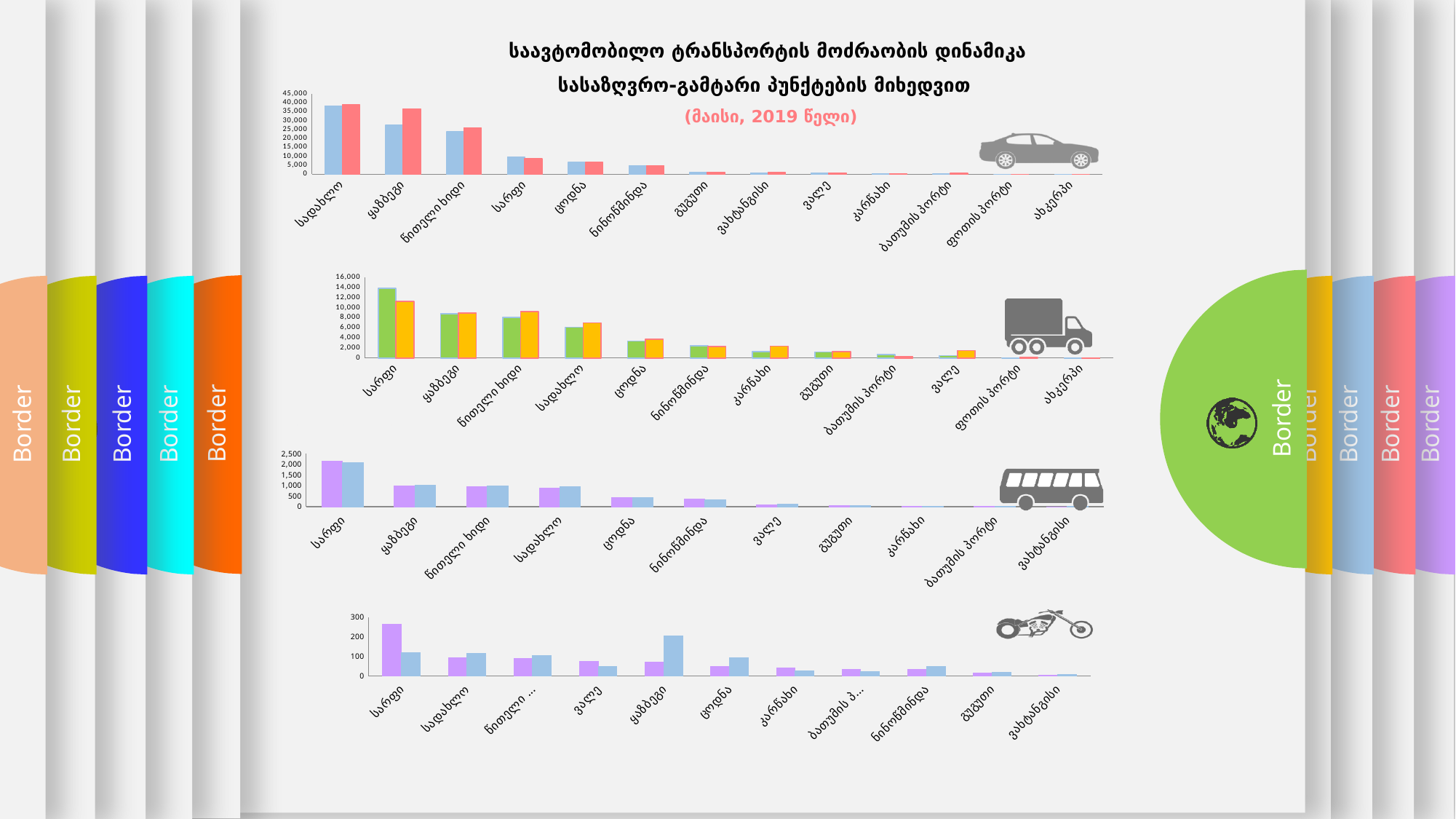
What period is given in the subtitle below the slide title? (მაისი, 2019 წელი) In the top chart (car icon), is the value for სარფი greater or less than 15,000? less How many categories are shown on the x axis of the second chart from the top (truck icon)? 12 How many categories are shown on the x axis of the third chart from the top (bus icon)? 11 In the top chart (car icon), is the value of the first (blue) bar for სადახლო greater or less than 30,000? greater In the top chart (car icon), which category has the highest bars? სადახლო What kind of chart is the top chart on the slide (with the car icon)? bar chart In the top chart (car icon), do the values generally rise or fall moving from left to right along the x axis? fall In the bottom chart (motorcycle icon), which category has the highest bar? სარფი In the second chart from the top (truck icon), is the value of the first (green) bar for სარფი greater or less than 10,000? greater In the second chart from the top (truck icon), which category has the highest bar? სარფი